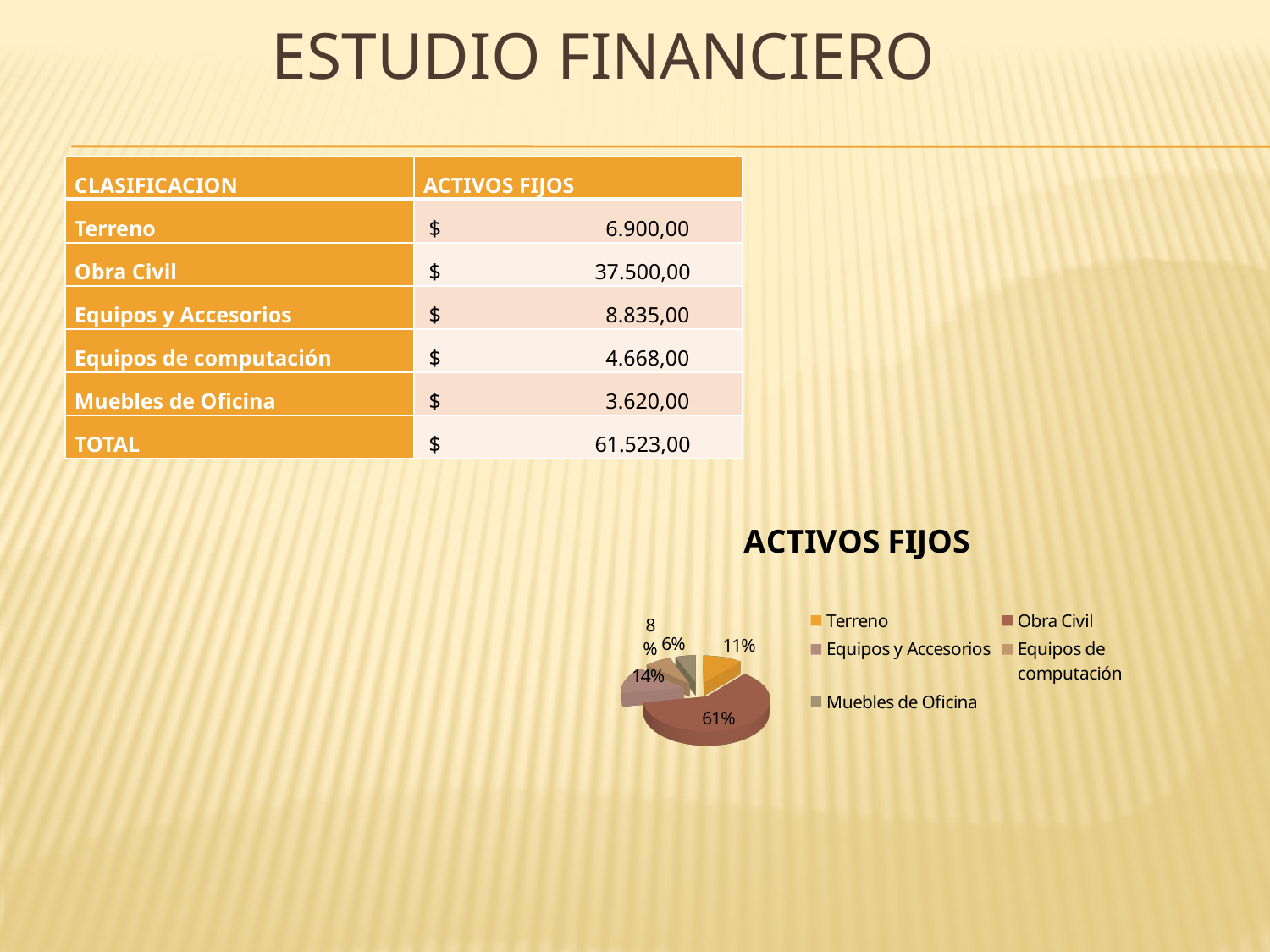
Which category has the smallest slice in the ACTIVOS FIJOS pie chart? Muebles de Oficina In the ACTIVOS FIJOS pie chart, what share does Equipos de computación have? 8% In the ACTIVOS FIJOS pie chart, what share does Terreno have? 11% In the ACTIVOS FIJOS pie chart, which is larger: the slice for Terreno or the slice for Equipos y Accesorios? Equipos y Accesorios In the ACTIVOS FIJOS pie chart, what share does Muebles de Oficina have? 6% Which category has the largest slice in the ACTIVOS FIJOS pie chart? Obra Civil What kind of chart is shown under the title ACTIVOS FIJOS? Pie chart What is the title of the pie chart on the slide? ACTIVOS FIJOS How many categories does the legend of the ACTIVOS FIJOS pie chart list? 5 In the ACTIVOS FIJOS pie chart, what is the difference in percentage points between the Obra Civil slice and the Equipos y Accesorios slice? 47